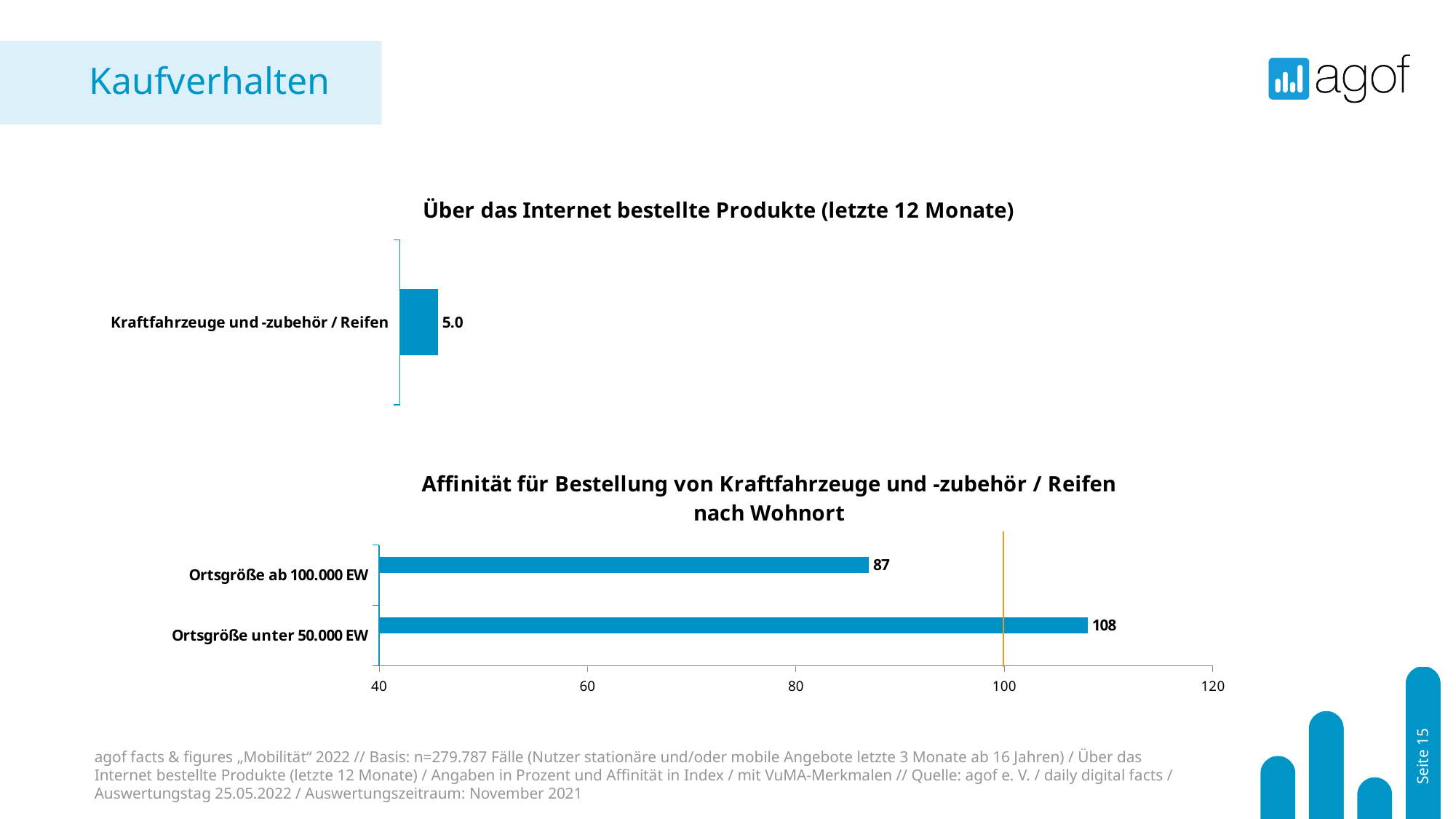
In the chart 'Über das Internet bestellte Produkte (letzte 12 Monate)', how many categories are plotted? 1 In the chart 'Affinität für Bestellung von Kraftfahrzeuge und -zubehör / Reifen nach Wohnort', what is the difference between the values for Ortsgröße unter 50.000 EW and Ortsgröße ab 100.000 EW? 21 What kind of chart is 'Über das Internet bestellte Produkte (letzte 12 Monate)'? bar chart In the chart 'Affinität für Bestellung von Kraftfahrzeuge und -zubehör / Reifen nach Wohnort', is the value for Ortsgröße unter 50.000 EW greater or less than 100? greater In the chart 'Affinität für Bestellung von Kraftfahrzeuge und -zubehör / Reifen nach Wohnort', what is the highest value shown on the x axis? 120 In the chart 'Affinität für Bestellung von Kraftfahrzeuge und -zubehör / Reifen nach Wohnort', which category has the highest value? Ortsgröße unter 50.000 EW In the chart 'Affinität für Bestellung von Kraftfahrzeuge und -zubehör / Reifen nach Wohnort', what is the value for Ortsgröße unter 50.000 EW? 108 In the chart 'Affinität für Bestellung von Kraftfahrzeuge und -zubehör / Reifen nach Wohnort', what is the value for Ortsgröße ab 100.000 EW? 87 In the chart 'Affinität für Bestellung von Kraftfahrzeuge und -zubehör / Reifen nach Wohnort', is the value for Ortsgröße ab 100.000 EW greater or less than 100? less In the chart 'Affinität für Bestellung von Kraftfahrzeuge und -zubehör / Reifen nach Wohnort', which category has the lowest value? Ortsgröße ab 100.000 EW In the chart 'Über das Internet bestellte Produkte (letzte 12 Monate)', what is the value for Kraftfahrzeuge und -zubehör / Reifen? 5.0 In the chart 'Affinität für Bestellung von Kraftfahrzeuge und -zubehör / Reifen nach Wohnort', how many categories are plotted? 2